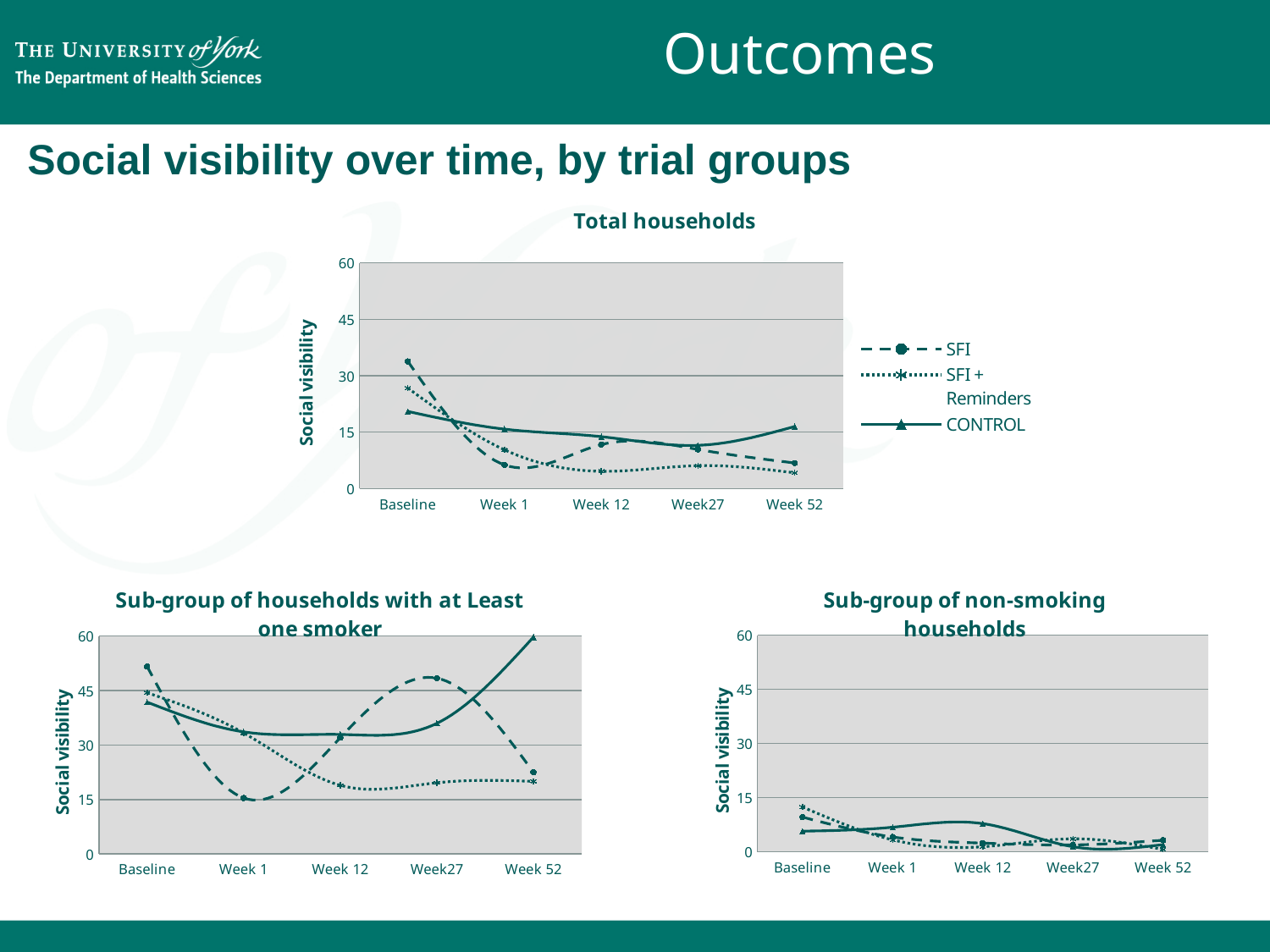
In the 'Sub-group of households with at Least one smoker' chart, which series has the lowest value at Week 1? SFI What is the y-axis label on the 'Total households' chart? Social visibility How many time points are shown on the x axis of the 'Total households' chart? 5 In the 'Sub-group of non-smoking households' chart, is the value for SFI + Reminders at Baseline greater or less than 30? less In the 'Sub-group of households with at Least one smoker' chart, which series has the highest value at Week 52? CONTROL In the 'Total households' chart, is the value for CONTROL at Baseline greater or less than 15? greater In the 'Sub-group of households with at Least one smoker' chart, is the value for SFI at Week 1 greater or less than 30? less What kind of chart is the 'Total households' chart? line chart In the 'Total households' chart, which series has the highest value at Baseline? SFI In the 'Total households' chart, does the SFI series rise or fall from Baseline to Week 52? fall How many series does the legend of the 'Total households' chart list? 3